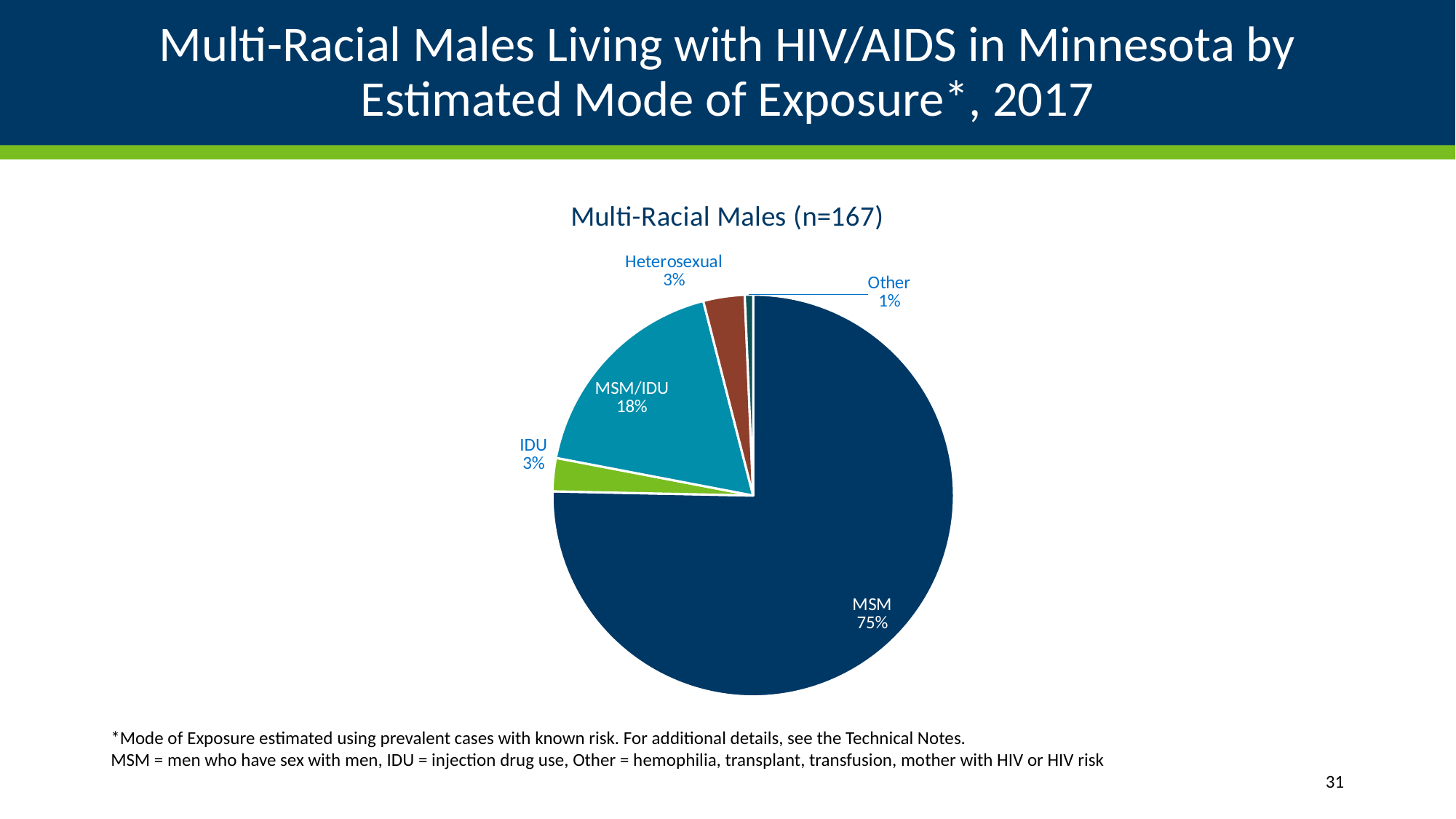
What percentage is shown for IDU? 3% Which mode of exposure has the smallest share of the pie? Other What percentage is shown for Heterosexual? 3% How many slices does the pie chart have? 5 What percentage is shown for MSM/IDU? 18% What percentage is shown for Other? 1% What kind of chart is shown on the slide? Pie chart What is the title of the chart? Multi-Racial Males (n=167) What is the difference in percentage points between MSM and MSM/IDU? 57 Which is larger, the share for MSM/IDU or the share for IDU? MSM/IDU Which mode of exposure has the largest share of the pie? MSM What share of the pie does MSM represent? 75%